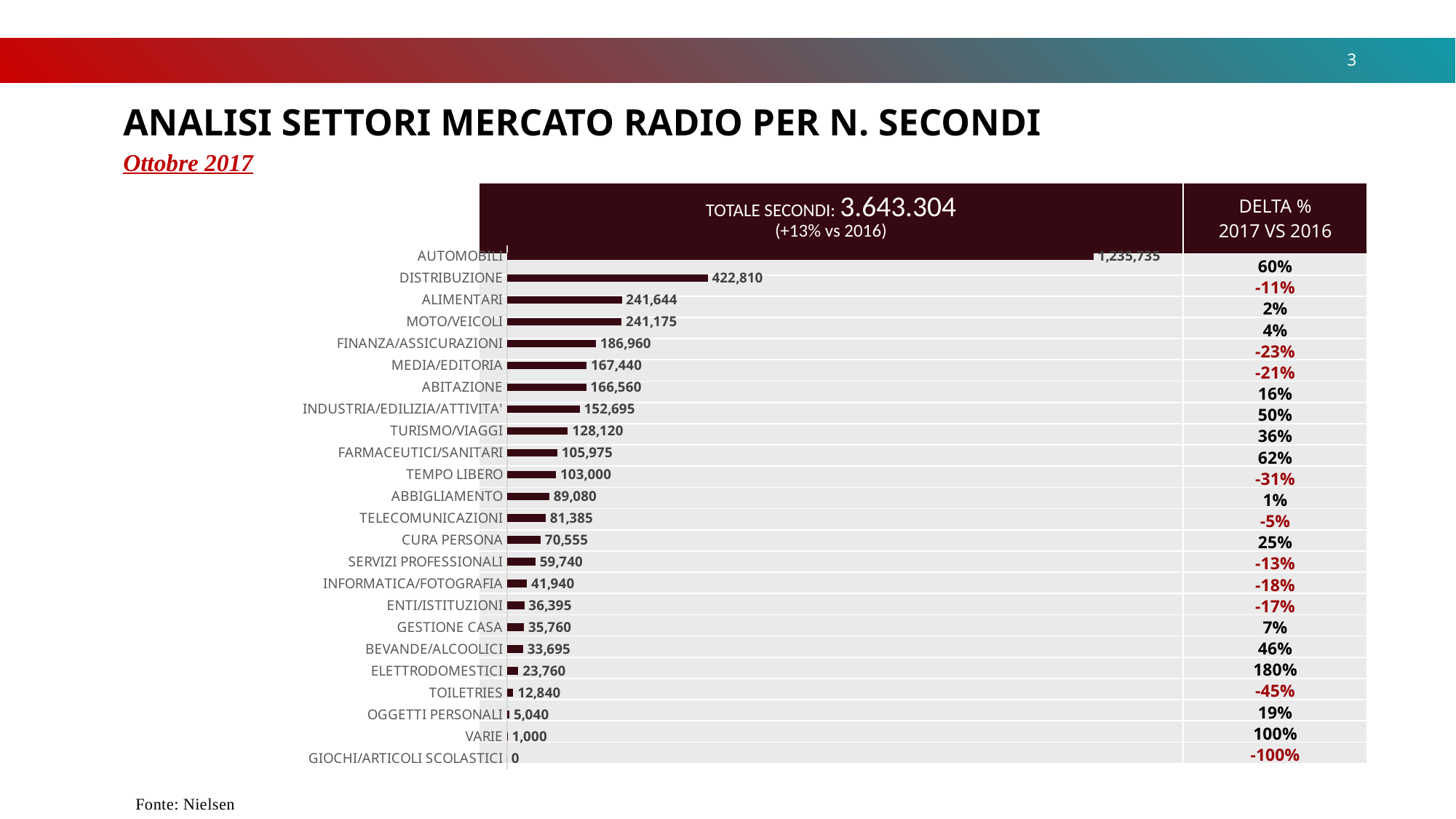
What total number of seconds is stated in the chart header? 3.643.304 What is the value for TURISMO/VIAGGI? 128,120 Which category has the lowest value? GIOCHI/ARTICOLI SCOLASTICI What is the difference between the values for DISTRIBUZIONE and ALIMENTARI? 181,166 How many categories are shown in the chart? 24 Which category has the highest value? AUTOMOBILI What is the value for TOILETRIES? 12,840 What kind of chart is shown on the slide? Bar chart What is the value for DISTRIBUZIONE? 422,810 What is the value for GIOCHI/ARTICOLI SCOLASTICI? 0 Which is larger, the value for FINANZA/ASSICURAZIONI or the value for MEDIA/EDITORIA? FINANZA/ASSICURAZIONI Do the bar values increase or decrease going from the top category to the bottom category? Decrease